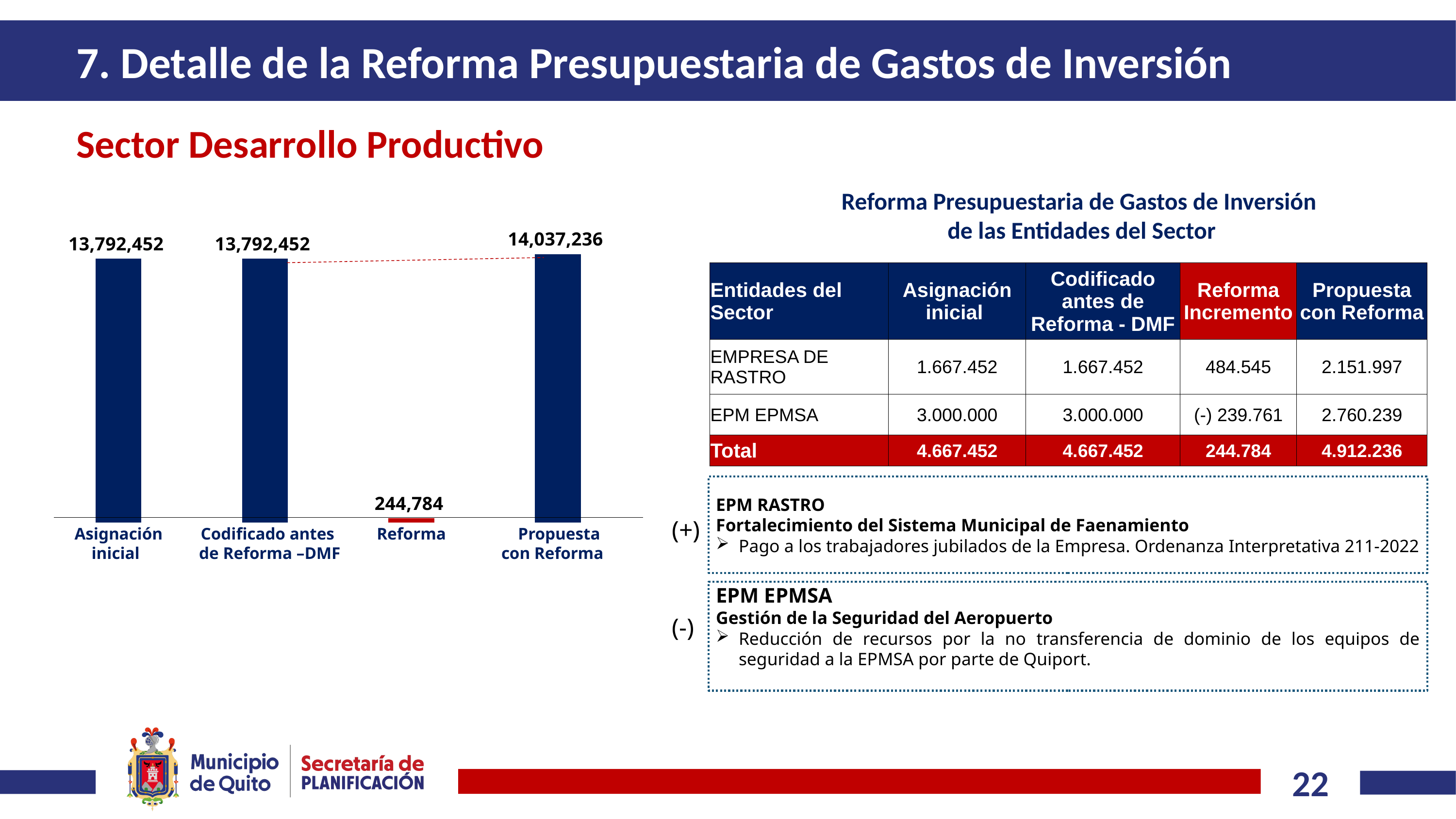
What is the value shown for Reforma in the chart? 244,784 What is the value shown for Propuesta con Reforma in the chart? 14,037,236 How many categories are shown on the x axis of the chart? 4 What is the sector name shown as the heading above the chart? Sector Desarrollo Productivo Which is larger in the chart, Propuesta con Reforma or Asignación inicial? Propuesta con Reforma What is the difference between Propuesta con Reforma and Codificado antes de Reforma –DMF in the chart? 244,784 What colour is the Reforma bar in the chart? Red What is the value shown for Codificado antes de Reforma –DMF in the chart? 13,792,452 What is the value shown for Asignación inicial in the chart? 13,792,452 Which category has the lowest value in the chart? Reforma What kind of chart is shown on the slide? Bar chart Which category has the highest value in the chart? Propuesta con Reforma